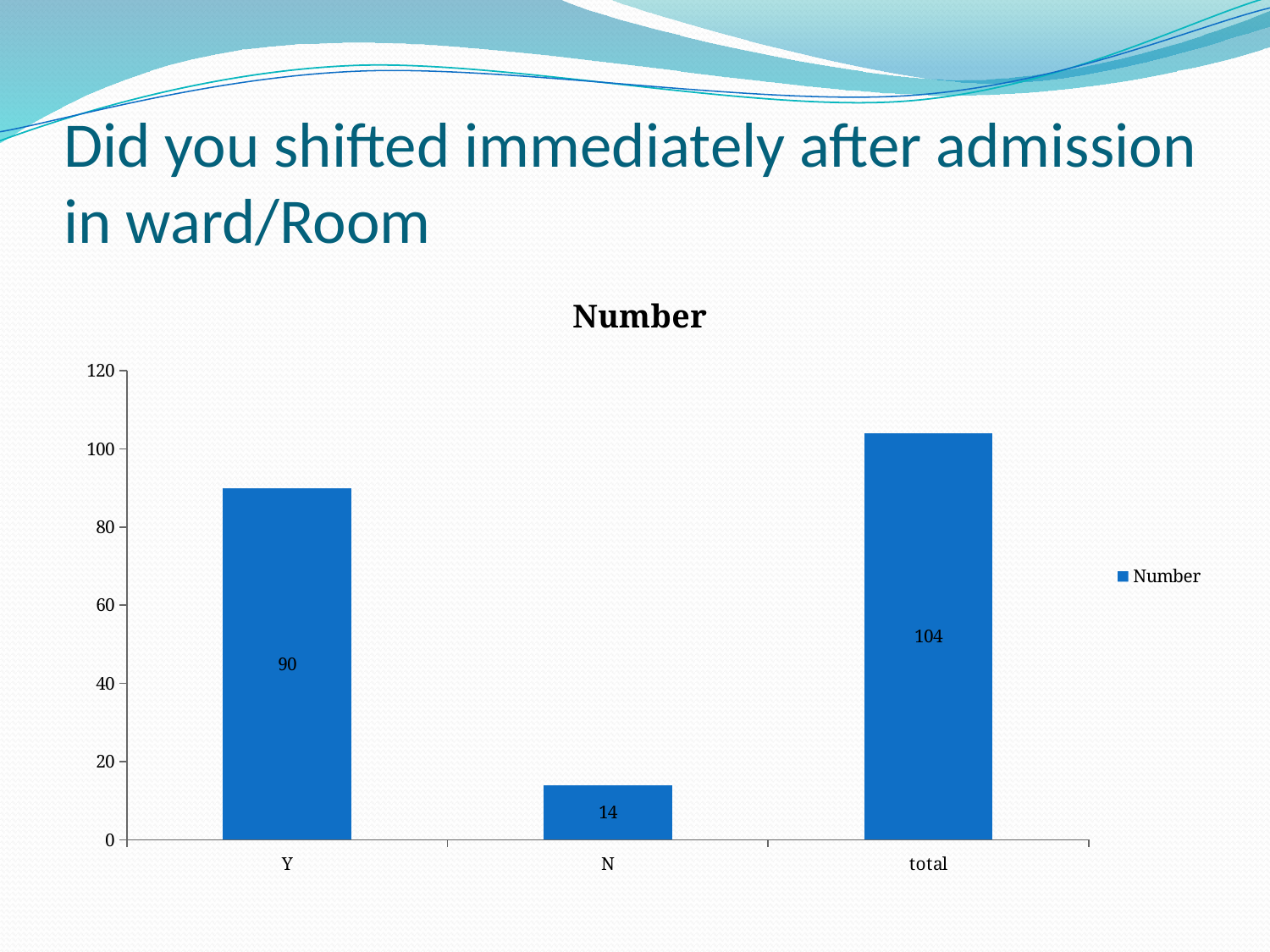
What is the value for Y? 90 What is the value for N? 14 How many categories are shown on the x axis? 3 What is the difference between the values for Y and N? 76 How many series does the legend list? 1 What is the value for total? 104 Which category has the lowest value? N What is the title of the chart? Number What kind of chart is shown? bar chart Which category has the highest value? total Which is larger, the value for Y or the value for N? Y Is the value for total greater or less than 100? greater